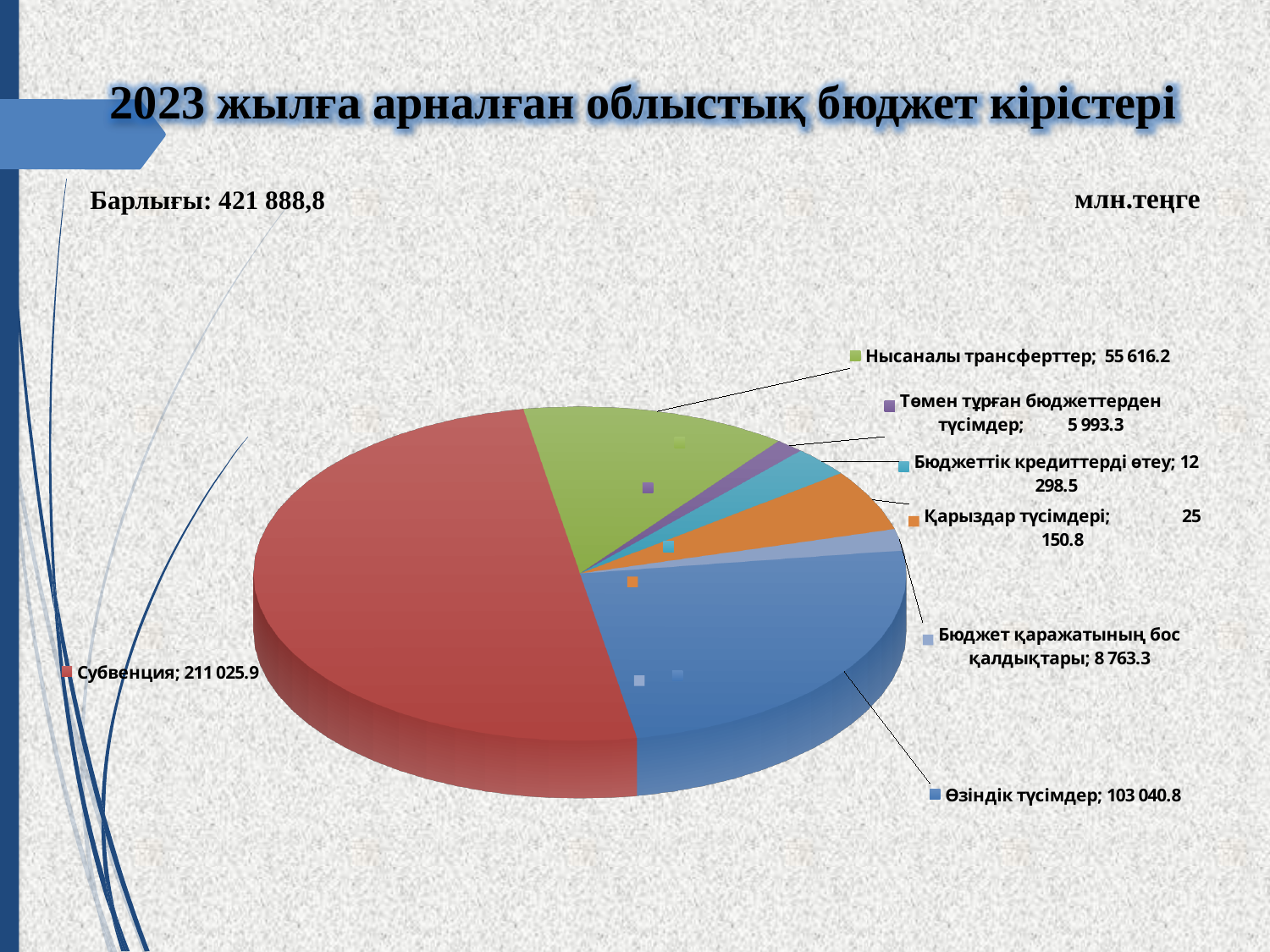
How many slices does the pie chart have? 7 Which category has the smallest slice of the pie? Төмен тұрған бюджеттерден түсімдер What is the value for Өзіндік түсімдер? 103 040.8 What total (Барлығы) is stated on the slide? 421 888,8 Which category has the largest slice of the pie? Субвенция What is the value for Нысаналы трансферттер? 55 616.2 What is the value for Бюджет қаражатының бос қалдықтары? 8 763.3 Which is larger: Қарыздар түсімдері or Бюджеттік кредиттерді өтеу? Қарыздар түсімдері What unit is stated for the values on the slide? млн.теңге What is the value for Субвенция? 211 025.9 What kind of chart is shown on the slide? pie chart What is the difference between Субвенция and Өзіндік түсімдер? 107 985.1